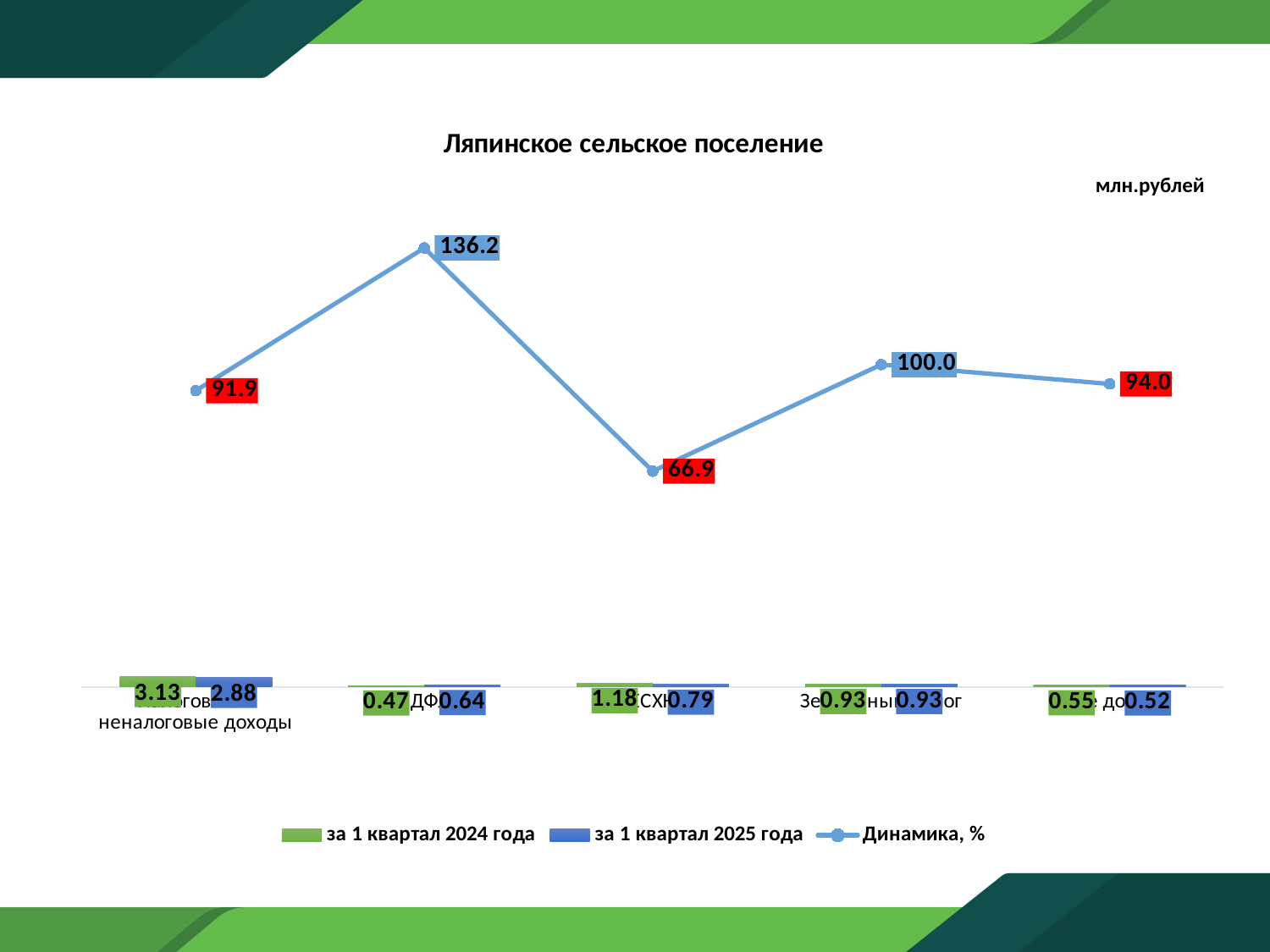
What is the value for 'за 1 квартал 2024 года' in the first (leftmost) category? 3.13 What kind of chart is shown on the slide? A combined bar and line chart What is the title of the chart? Ляпинское сельское поселение Which category has the highest 'Динамика, %' value? The second category from the left (136.2) How many series does the legend list? 3 In the third category from the left, which is larger: the value for 'за 1 квартал 2024 года' or 'за 1 квартал 2025 года'? за 1 квартал 2024 года (1.18) Which category has the lowest 'Динамика, %' value? The third category from the left (66.9) What is the 'Динамика, %' value for the last (rightmost) category? 94.0 What is the value of 'Динамика, %' for the second category from the left? 136.2 What unit is indicated at the top right of the chart? млн.рублей How many categories are plotted along the x axis? 5 What is the difference between the 2024 and 2025 values in the first (leftmost) category? 0.25